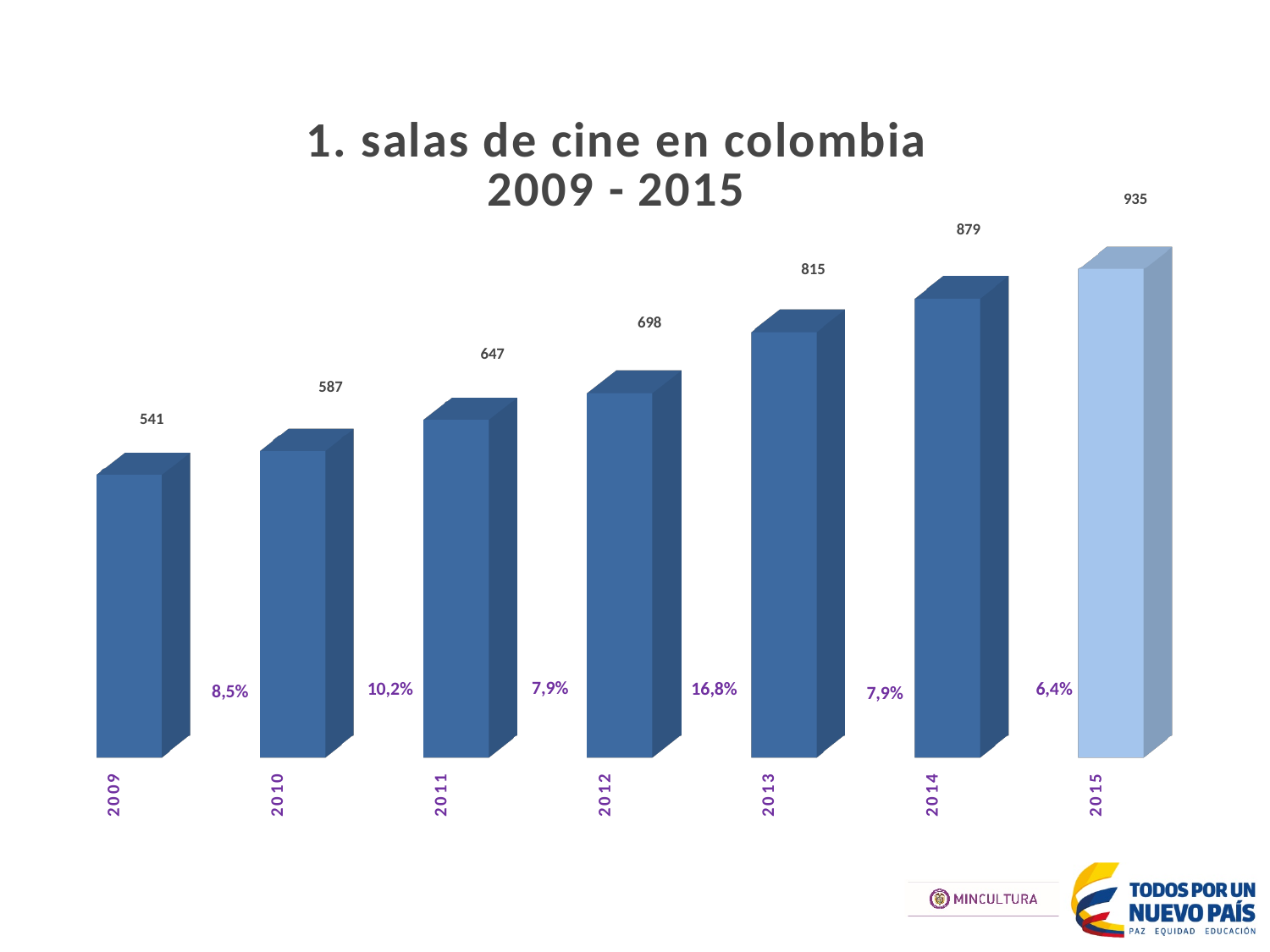
What kind of chart is this? bar chart Which year has the highest value? 2015 Which is larger, the value for 2011 or the value for 2012? 2012 What is the difference between the values for 2014 and 2013? 64 Do the values rise or fall from 2009 to 2015? rise How many years are shown on the chart? 7 What is the value for 2015? 935 Which year has the lowest value? 2009 What is the difference between the values for 2015 and 2009? 394 What is the value for 2013? 815 What percentage growth is shown between 2012 and 2013? 16,8% What is the value for 2009? 541